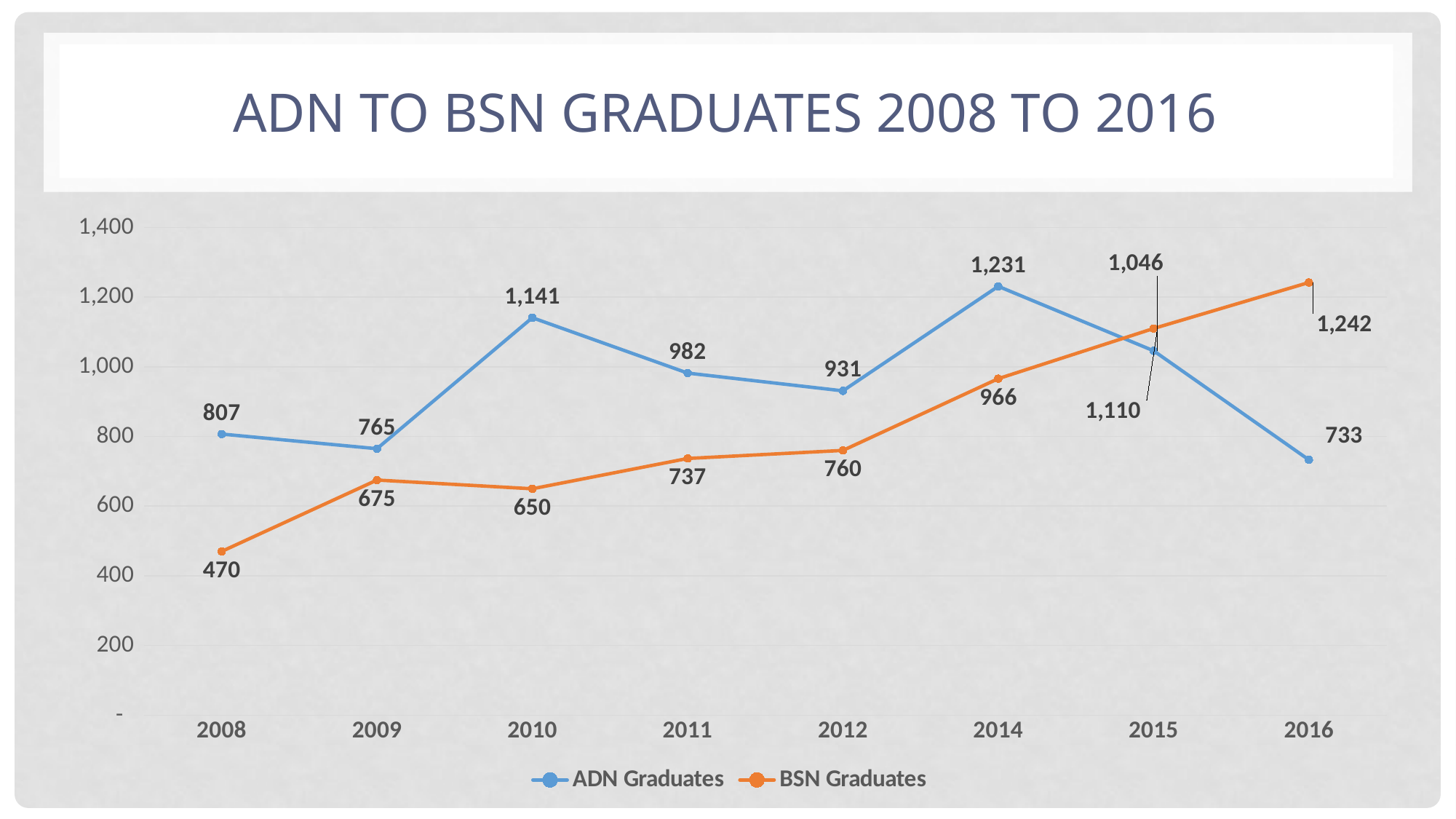
What is the value for ADN Graduates in 2010? 1,141 How many years are shown on the x axis? 8 Do the BSN Graduates values rise or fall from 2012 to 2016? rise Is the value for BSN Graduates in 2014 greater or less than 800? greater In which year is the ADN Graduates value highest? 2014 What is the value for BSN Graduates in 2008? 470 What is the difference between BSN Graduates and ADN Graduates in 2016? 509 In 2012, which series has the larger value, ADN Graduates or BSN Graduates? ADN Graduates How many series does the legend list? 2 In which year is the BSN Graduates value lowest? 2008 What kind of chart is shown on the slide? line chart What is the value for BSN Graduates in 2015? 1,110